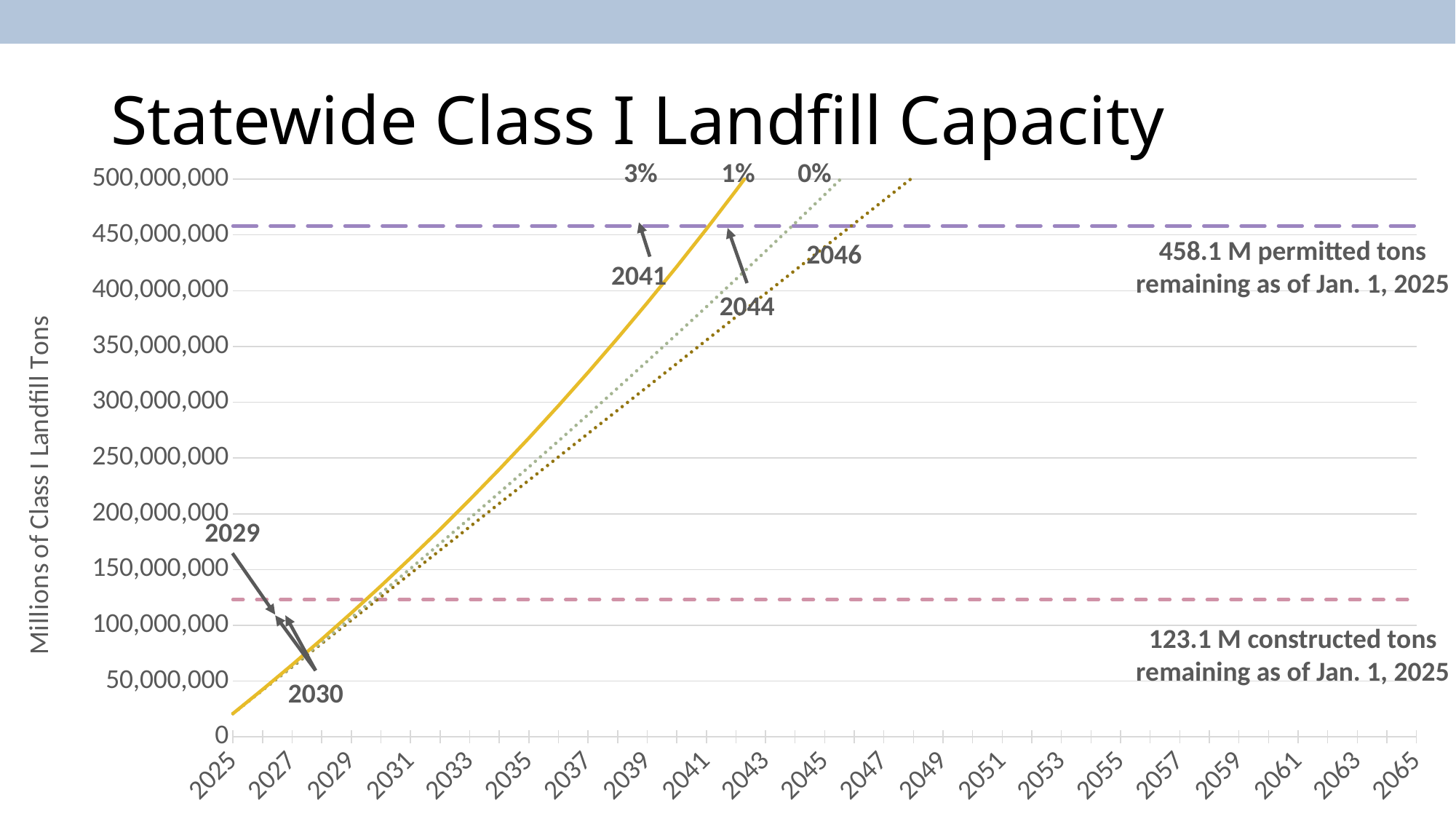
How many constructed tons remain as of Jan. 1, 2025, according to the lower dashed line? 123.1 M What is the difference between the permitted tons remaining and the constructed tons remaining as of Jan. 1, 2025? 335.0 M In which year does the 1% growth scenario reach the permitted capacity line? 2044 What is the label on the vertical axis of the chart? Millions of Class I Landfill Tons What is the title of the chart? Statewide Class I Landfill Capacity In which year does the 0% growth scenario reach the permitted capacity line? 2046 How many growth scenario lines are plotted on the chart? 3 What kind of chart is shown on the slide? line chart How many permitted tons remain as of Jan. 1, 2025, according to the upper dashed line? 458.1 M Is the value of the 3% scenario line in 2031 greater or less than 200,000,000? less Which growth scenario reaches the permitted capacity line earliest? 3% In which year does the 3% growth scenario reach the permitted capacity line? 2041